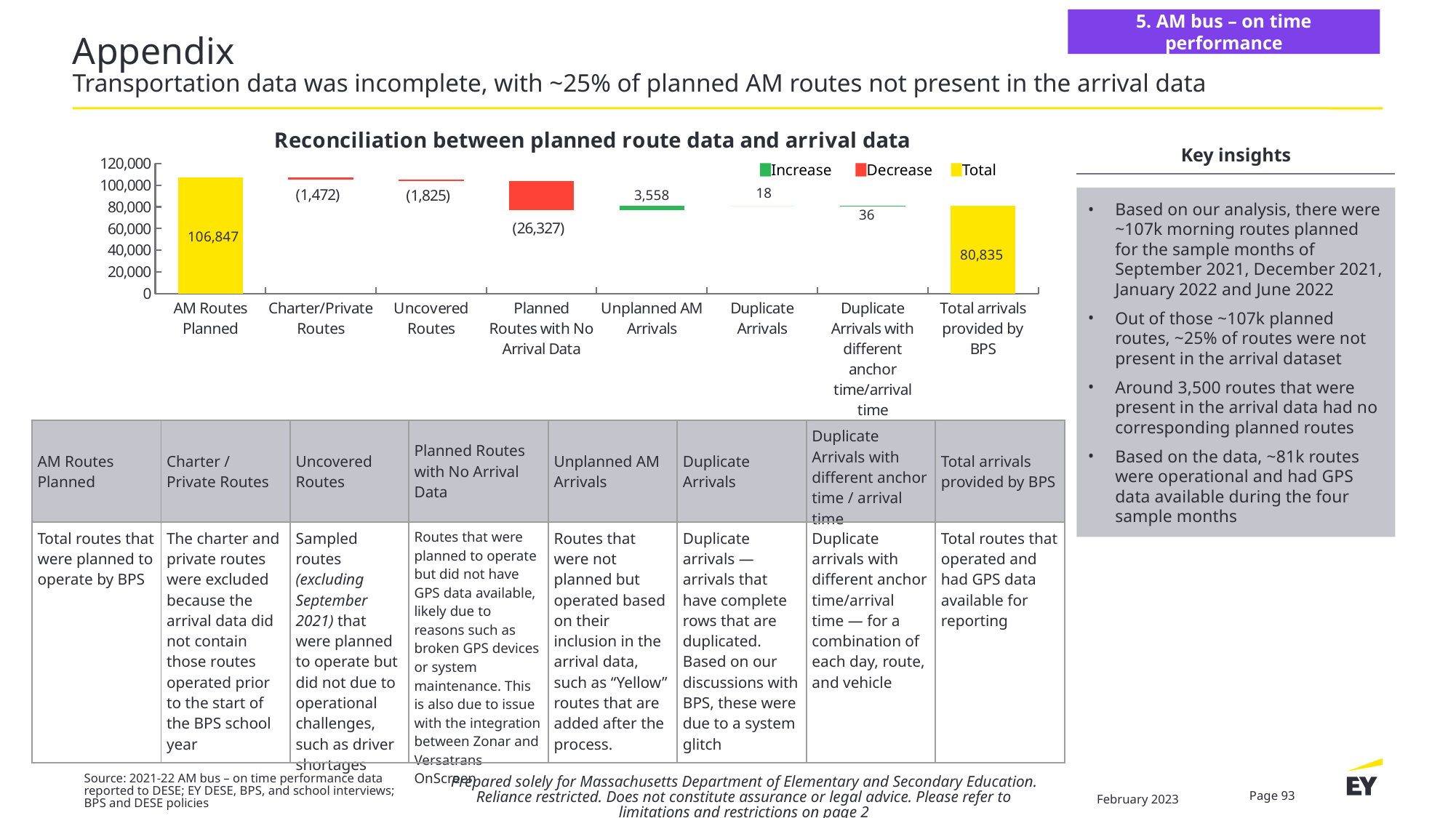
Which category has the largest decrease in the chart? Planned Routes with No Arrival Data How many entries does the chart legend list? 3 Which decrease is larger: Charter/Private Routes or Uncovered Routes? Uncovered Routes Which category has the smallest labelled value in the chart? Duplicate Arrivals What is the value shown for Total arrivals provided by BPS? 80,835 What value is labelled for Duplicate Arrivals? 18 What is the difference between AM Routes Planned and Total arrivals provided by BPS? 26,012 Is the value for AM Routes Planned greater or less than 100,000? greater What value is labelled for Planned Routes with No Arrival Data? (26,327) How many categories are shown on the x axis of the chart? 8 What is the value shown for AM Routes Planned? 106,847 What value is labelled for Unplanned AM Arrivals? 3,558